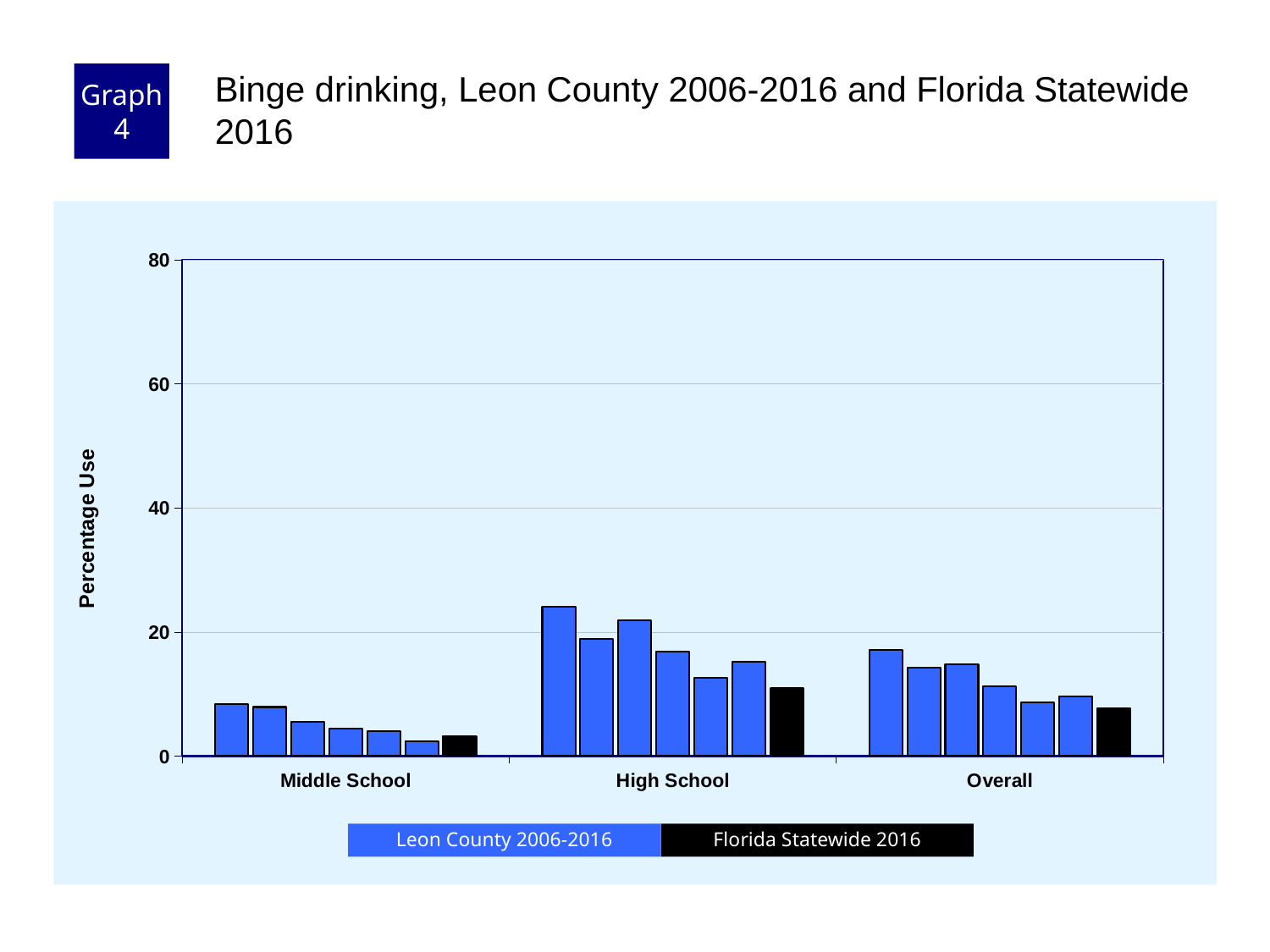
What colour are the Florida Statewide 2016 bars? black Is the value for Florida Statewide 2016 in the Middle School category greater or less than 20? less In the High School category, is the Florida Statewide 2016 bar larger or smaller than the first Leon County bar? smaller Is the tallest Leon County bar in the High School category greater or less than 20? greater How many series does the legend list? 2 What kind of chart is shown on the slide? bar chart Which category has the lowest bars overall? Middle School What is the label on the y axis? Percentage Use Do the Leon County 2006-2016 bars in the Middle School category generally rise or fall from left to right? fall Is the value for Florida Statewide 2016 in the High School category greater or less than 20? less How many categories are shown on the x axis? 3 Which category has the highest bars overall? High School